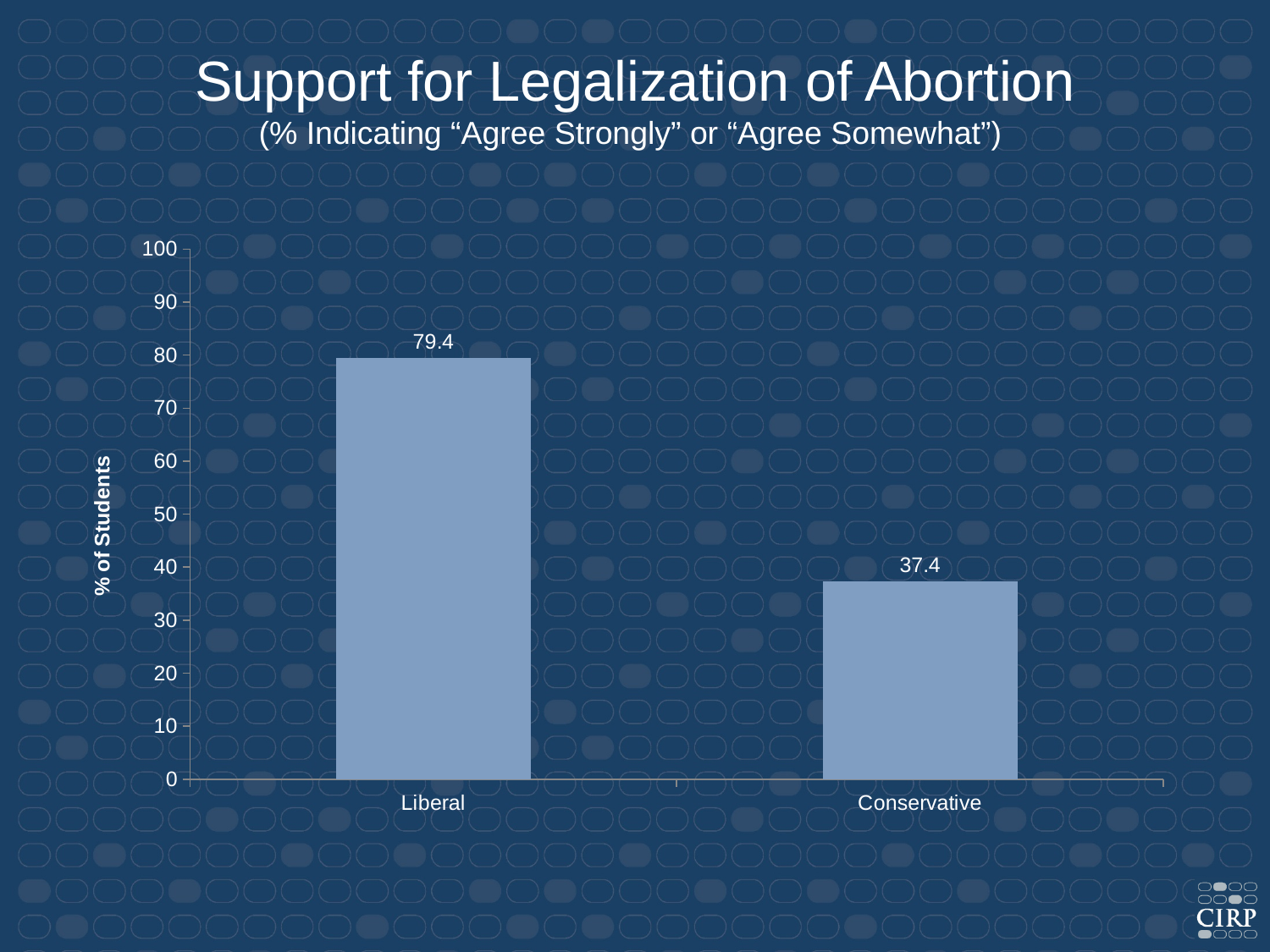
How many categories are shown on the x axis? 2 Which is larger, the value for Liberal or the value for Conservative? Liberal What is the title of the chart? Support for Legalization of Abortion What is the label of the y axis? % of Students What is the difference between the values for Liberal and Conservative? 42 Is the value for Conservative greater or less than 40? less What is the value for Conservative? 37.4 Which category has the lowest value? Conservative Is the value for Liberal greater or less than 70? greater What is the value for Liberal? 79.4 What kind of chart is shown on the slide? bar chart Which category has the highest value? Liberal